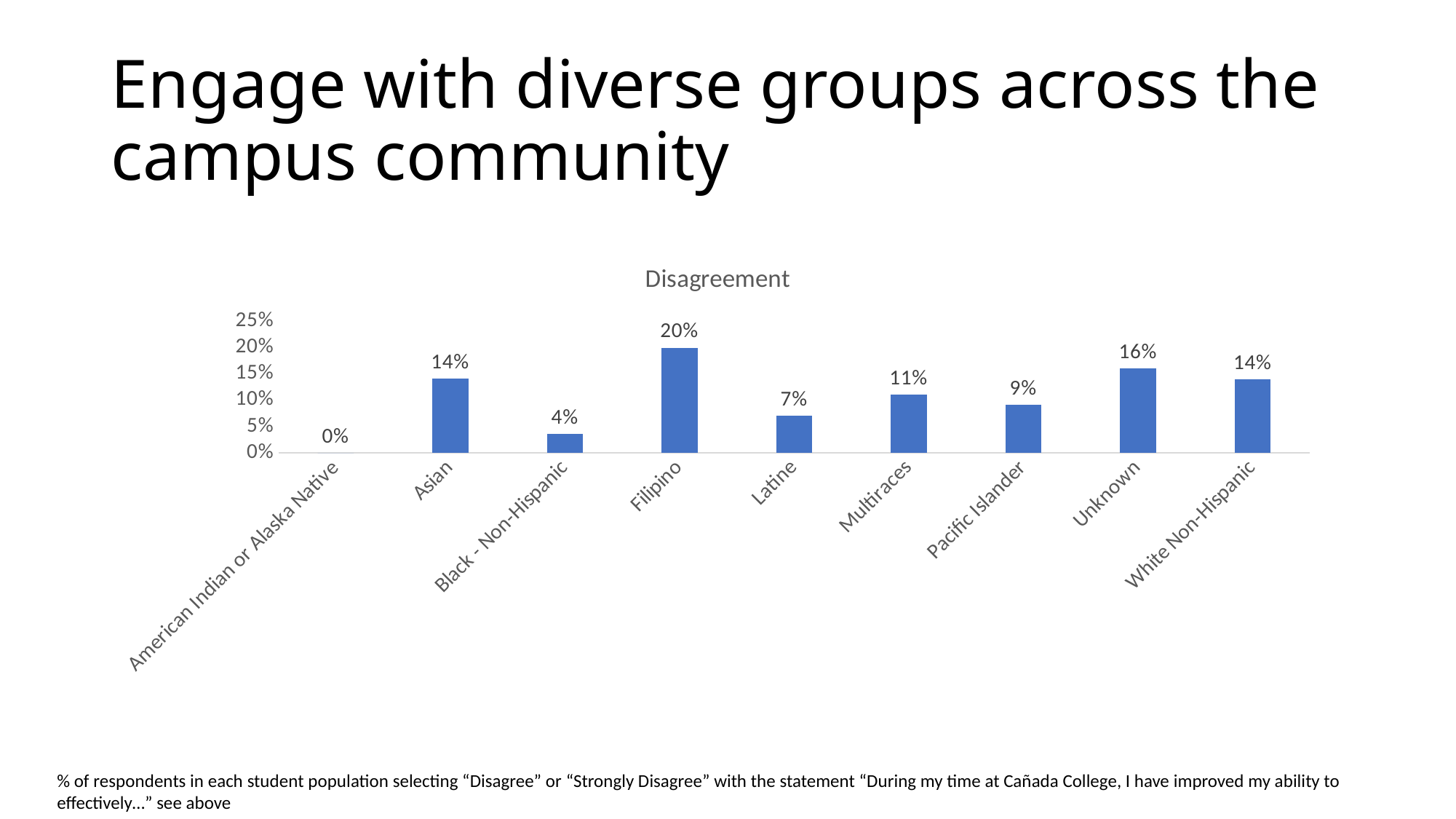
Which student population has the lowest disagreement percentage? American Indian or Alaska Native What is the disagreement percentage for Unknown? 16% How many student populations are shown on the x axis? 9 Which student population has the highest disagreement percentage? Filipino What is the disagreement percentage for Filipino students? 20% What is the title of the chart? Disagreement Which has a higher disagreement percentage, Multiraces or Pacific Islander? Multiraces What is the highest value shown on the y axis? 25% What kind of chart is shown on the slide? Bar chart Is the value for Unknown greater or less than 15%? greater What is the disagreement percentage for Black - Non-Hispanic students? 4% What is the difference between the disagreement percentages for Filipino and Latine students? 13%